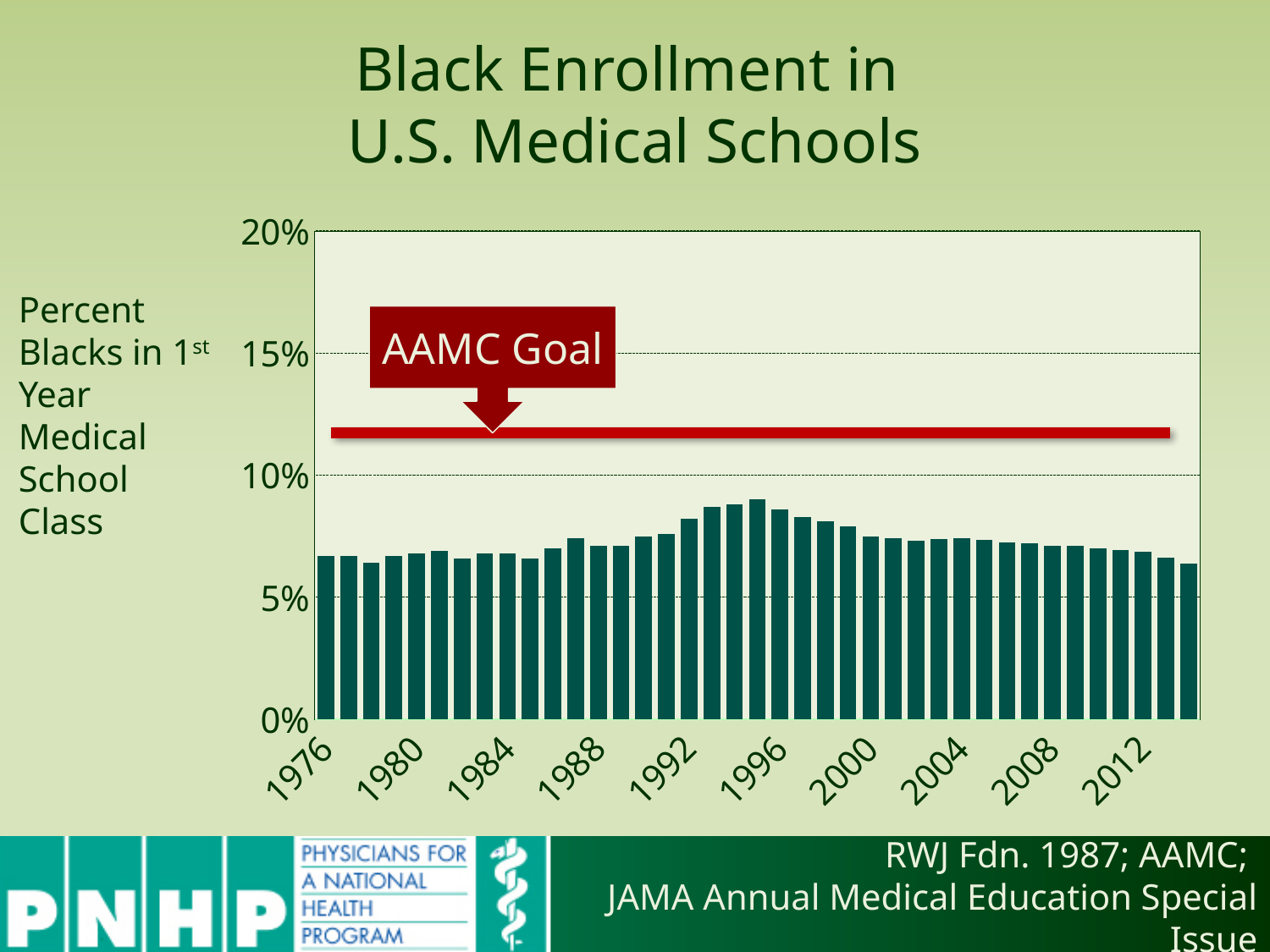
What kind of chart is shown on the slide? bar chart What is the title of the chart? Black Enrollment in U.S. Medical Schools What does the red horizontal line on the chart represent? AAMC Goal Does any bar on the chart reach the AAMC Goal line? No Is the value for 1995 greater or less than 10%? less Is the value for 2013 greater or less than 10%? less Is the AAMC Goal line above or below 10%? above Which is larger, the value for 1995 or the value for 1976? 1995 Do the values rise or fall from 1996 to 2013? fall Which is larger, the value for 2000 or the value for 2012? 2000 Do the values rise or fall from 1988 to 1995? rise